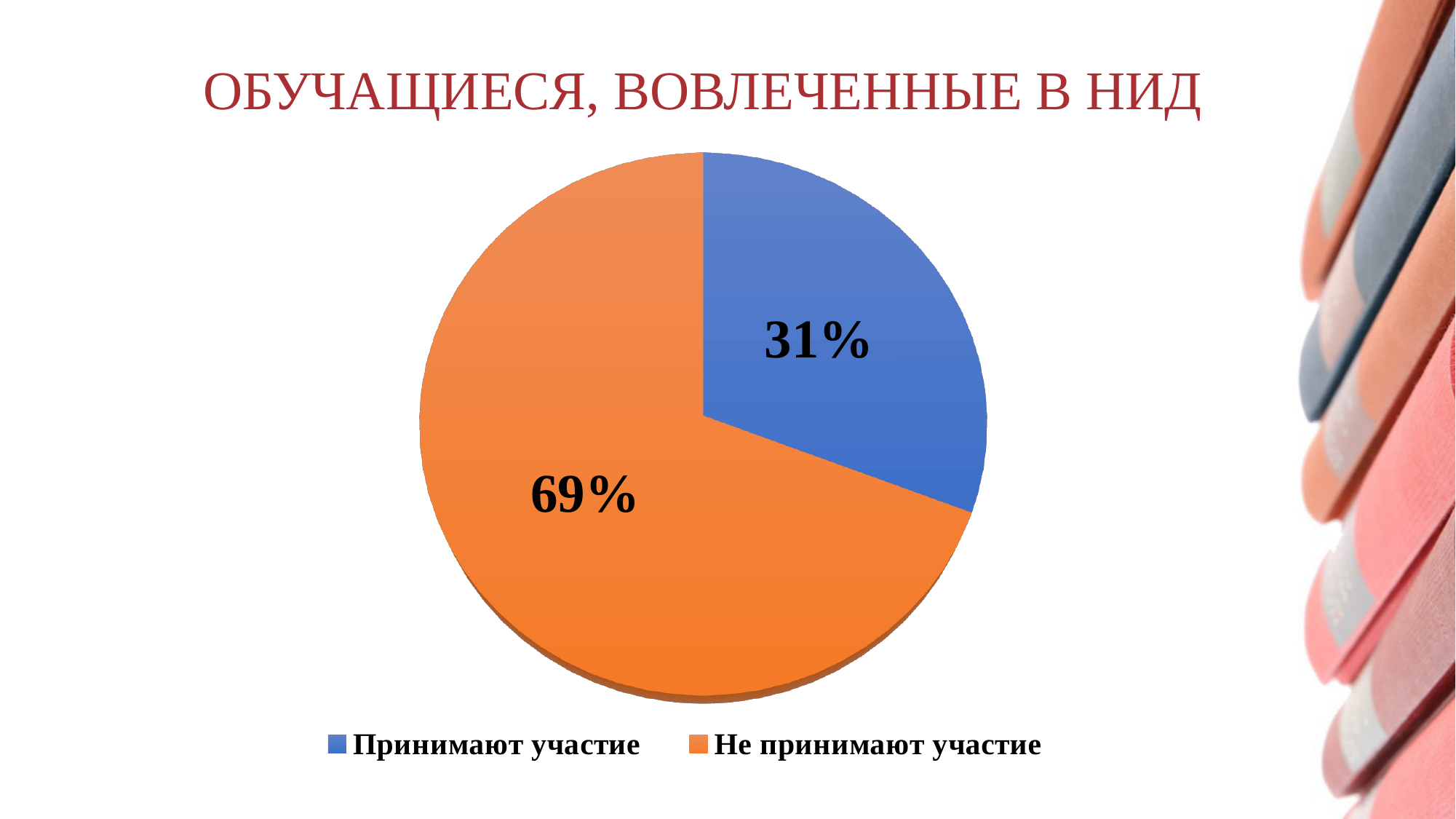
What share of the pie is labelled "Не принимают участие"? 69% How many slices does the pie chart have? 2 What colour is the slice for "Принимают участие"? blue Which is larger: "Принимают участие" or "Не принимают участие"? Не принимают участие What kind of chart is shown on the slide? pie chart What is the title of the slide? ОБУЧАЩИЕСЯ, ВОВЛЕЧЕННЫЕ В НИД What is the total of the two slices' percentages? 100% Which slice is the largest? Не принимают участие Which slice is the smallest? Принимают участие How many entries does the legend list? 2 What is the difference in percentage points between "Не принимают участие" and "Принимают участие"? 38 What share of the pie is labelled "Принимают участие"? 31%